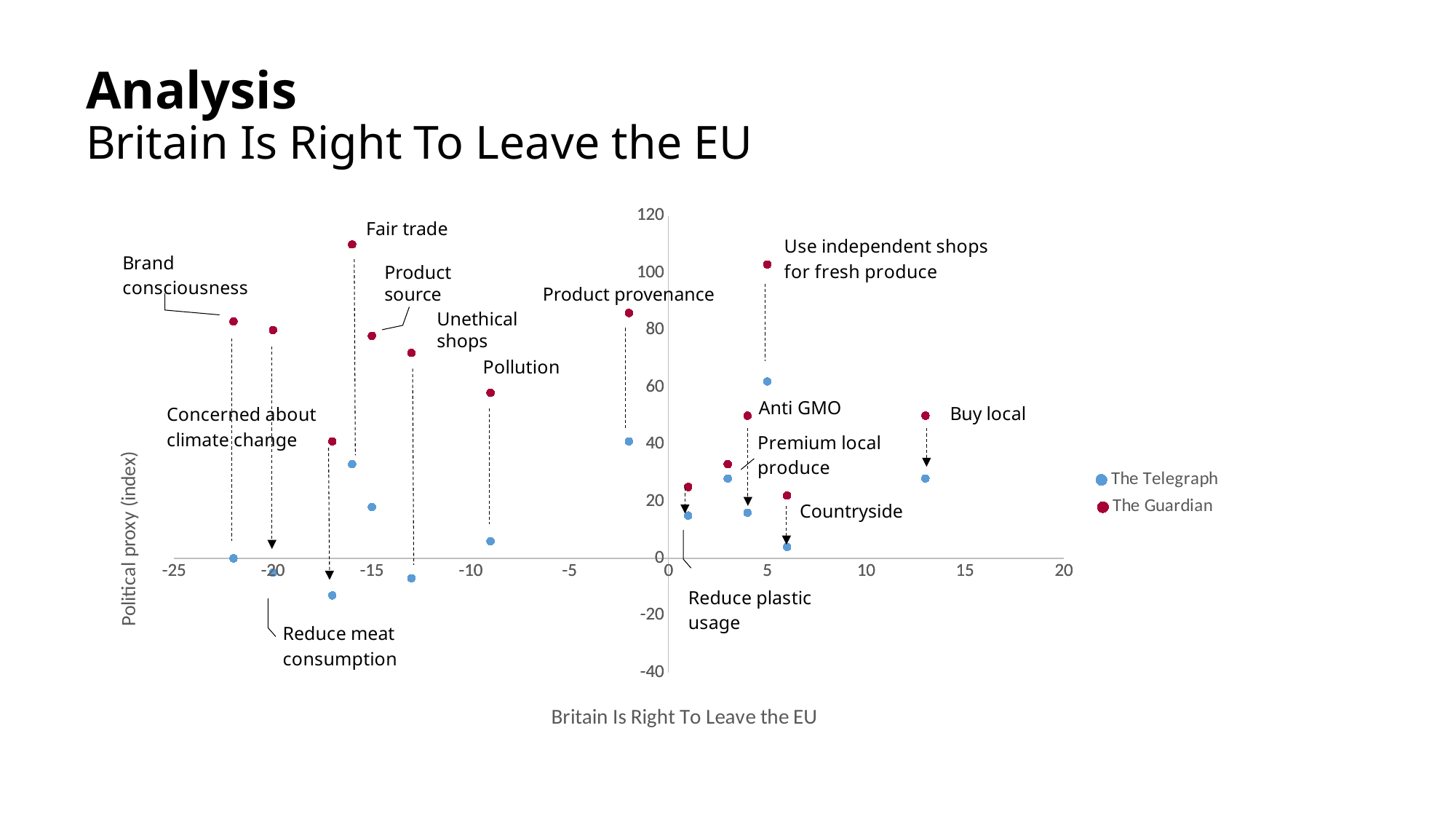
Is The Telegraph value for Brand consciousness greater or less than 20? less Which topic has the highest value for The Telegraph series? Use independent shops for fresh produce Is The Guardian value for Fair trade greater or less than 100? greater Is The Guardian value for Pollution greater or less than 40? greater Which two series are listed in the chart legend? The Telegraph and The Guardian How many series does the legend list? 2 What kind of chart is shown on the slide? Scatter chart What is the title of the horizontal axis of the chart? Britain Is Right To Leave the EU For Product provenance, which series has the larger value, The Telegraph or The Guardian? The Guardian For Buy local, which series has the larger value, The Guardian or The Telegraph? The Guardian How many labelled topics are plotted on the chart? 14 Which topic has the highest value for The Guardian series? Fair trade